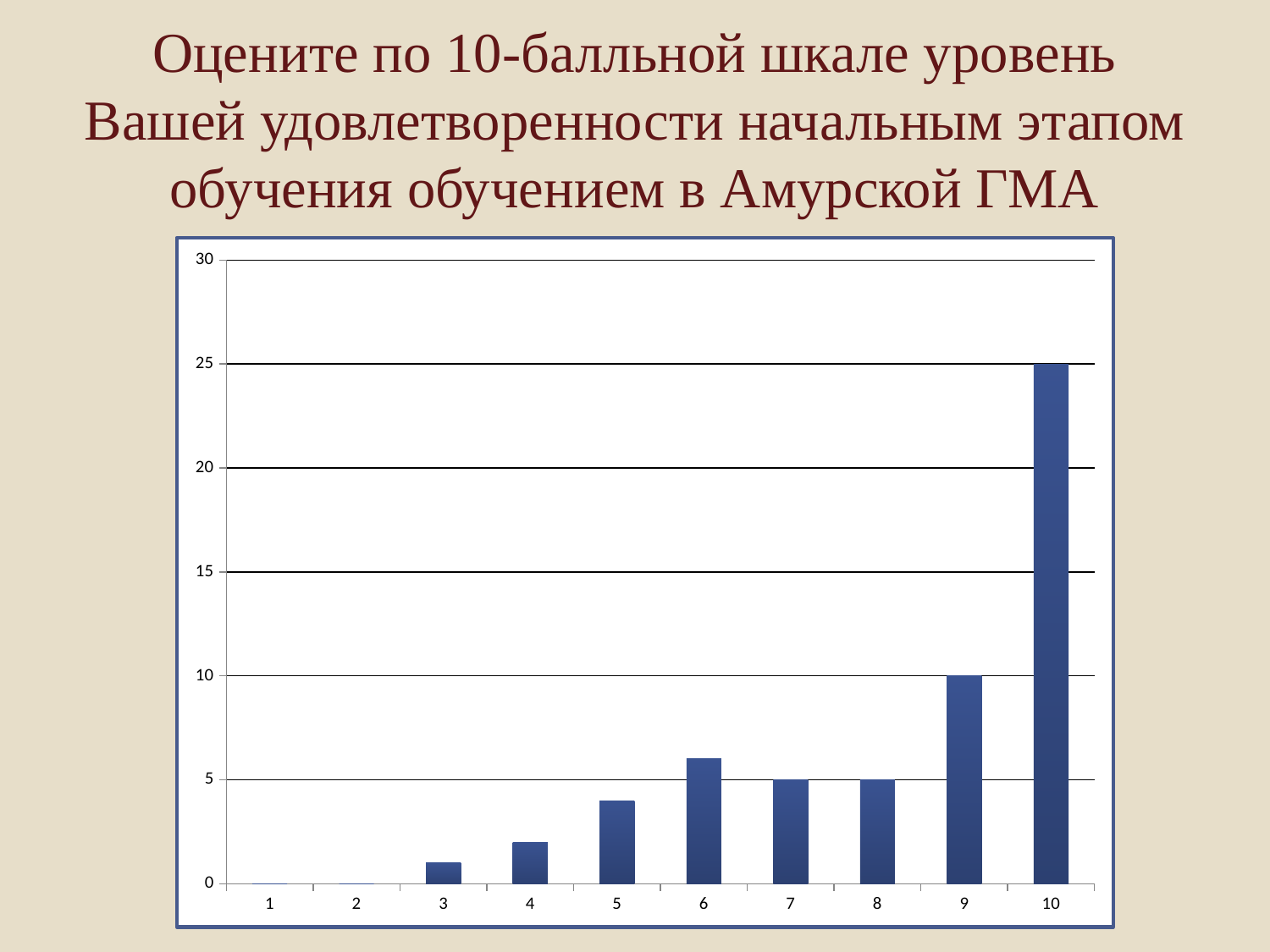
What is the value for category 8? 5 Is the value for category 4 greater or less than 5? less What kind of chart is shown on the slide? bar chart What is the difference between the values for category 10 and category 9? 15 What is the value for category 7? 5 How many categories are shown on the x axis of the chart? 10 Is the value for category 6 greater or less than 5? greater Which is larger, the value for category 9 or the value for category 10? category 10 What is the value for category 10? 25 Which category has the highest bar in the chart? 10 Do the values generally rise or fall from category 1 to category 10? rise What is the value for category 9? 10